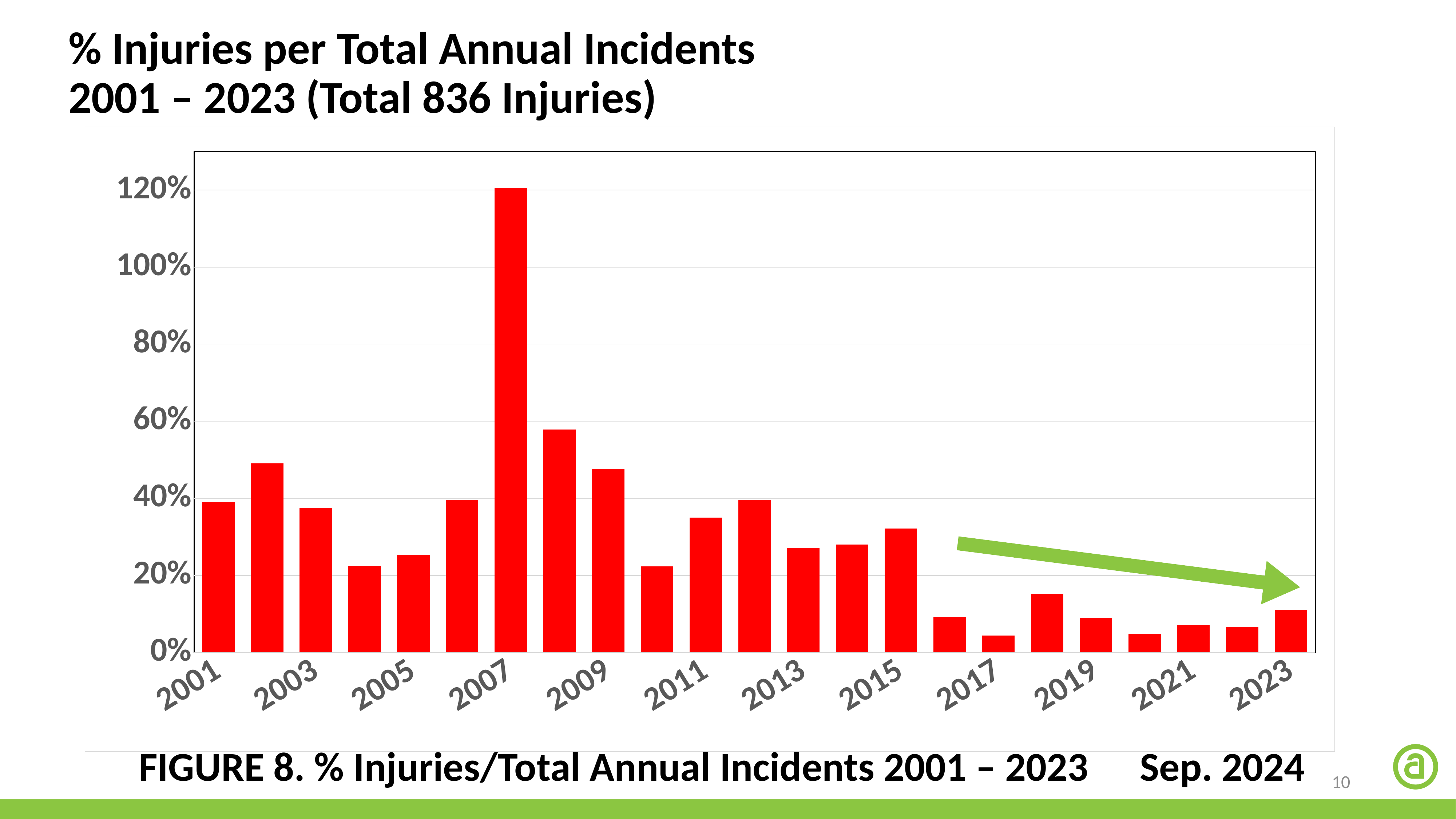
What colour are the bars in the chart? red Which year has the larger value, 2001 or 2021? 2001 Is the value for 2007 greater or less than 100%? greater Is the value for 2023 greater or less than 20%? less Is the value for 2009 greater or less than 40%? greater Which year has the larger value, 2007 or 2009? 2007 How many bars (years) are plotted in the chart? 23 Do the values generally rise or fall from 2015 to 2023? fall Which year has the highest % injuries per total annual incidents? 2007 What kind of chart is shown on the slide? bar chart